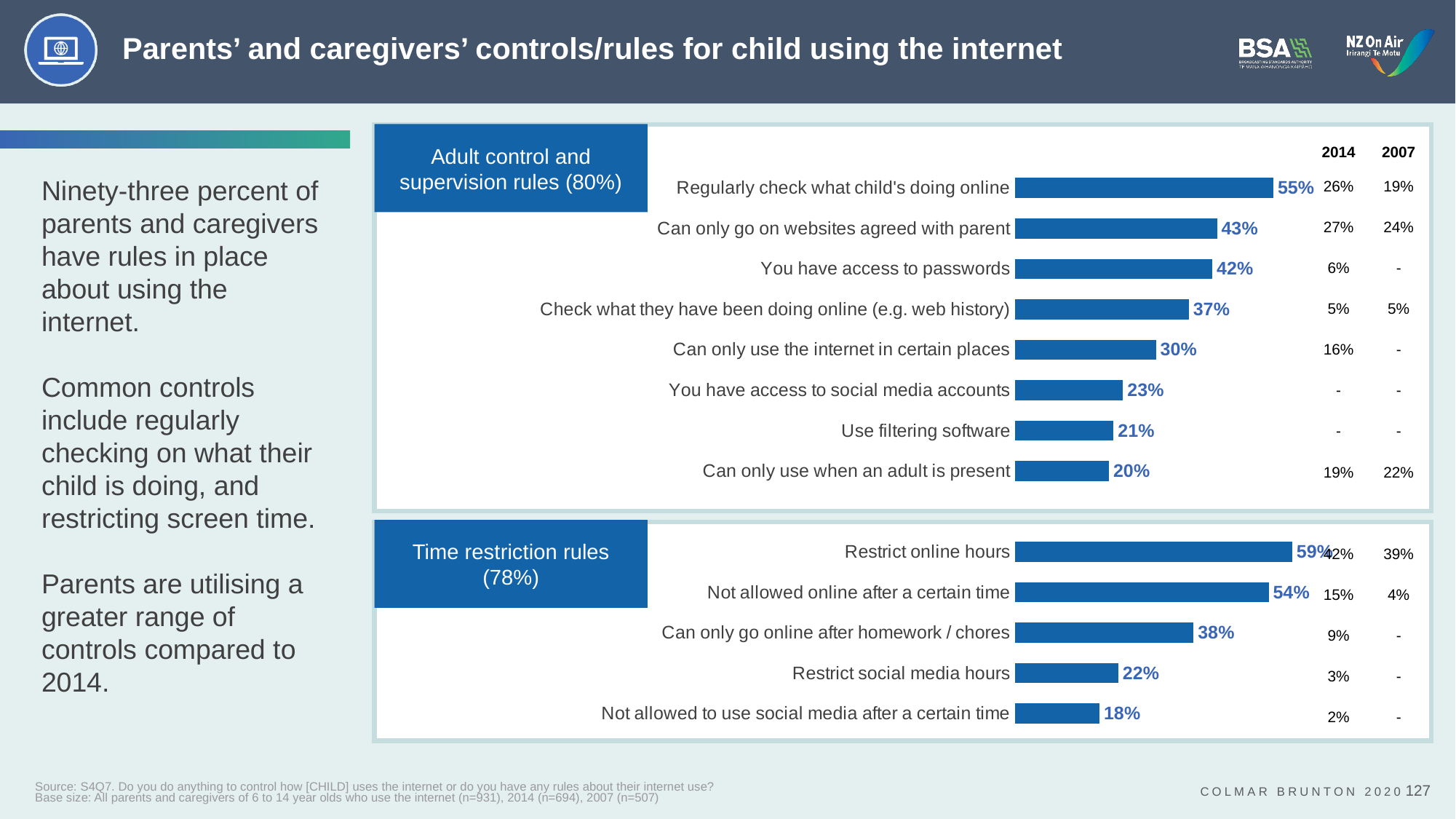
In the Time restriction rules chart, how many rules are listed? 5 In the Adult control and supervision rules chart, which control has the highest value? Regularly check what child's doing online In the Adult control and supervision rules chart, which control has the lowest value? Can only use when an adult is present In the Time restriction rules chart, which rule has the highest value? Restrict online hours In the Time restriction rules chart, which is larger: 'Can only go online after homework / chores' or 'Restrict social media hours'? Can only go online after homework / chores In the Adult control and supervision rules chart, what is the difference between 'Regularly check what child's doing online' and 'Can only go on websites agreed with parent'? 12% In the Time restriction rules chart, what is the value for 'Not allowed online after a certain time'? 54% In the Time restriction rules chart, which rule has the lowest value? Not allowed to use social media after a certain time What type of chart is used in the Time restriction rules chart? Bar chart In the Adult control and supervision rules chart, what is the value for 'You have access to passwords'? 42% In the Adult control and supervision rules chart, how many controls are listed? 8 In the Adult control and supervision rules chart, what percentage of parents regularly check what their child is doing online? 55%